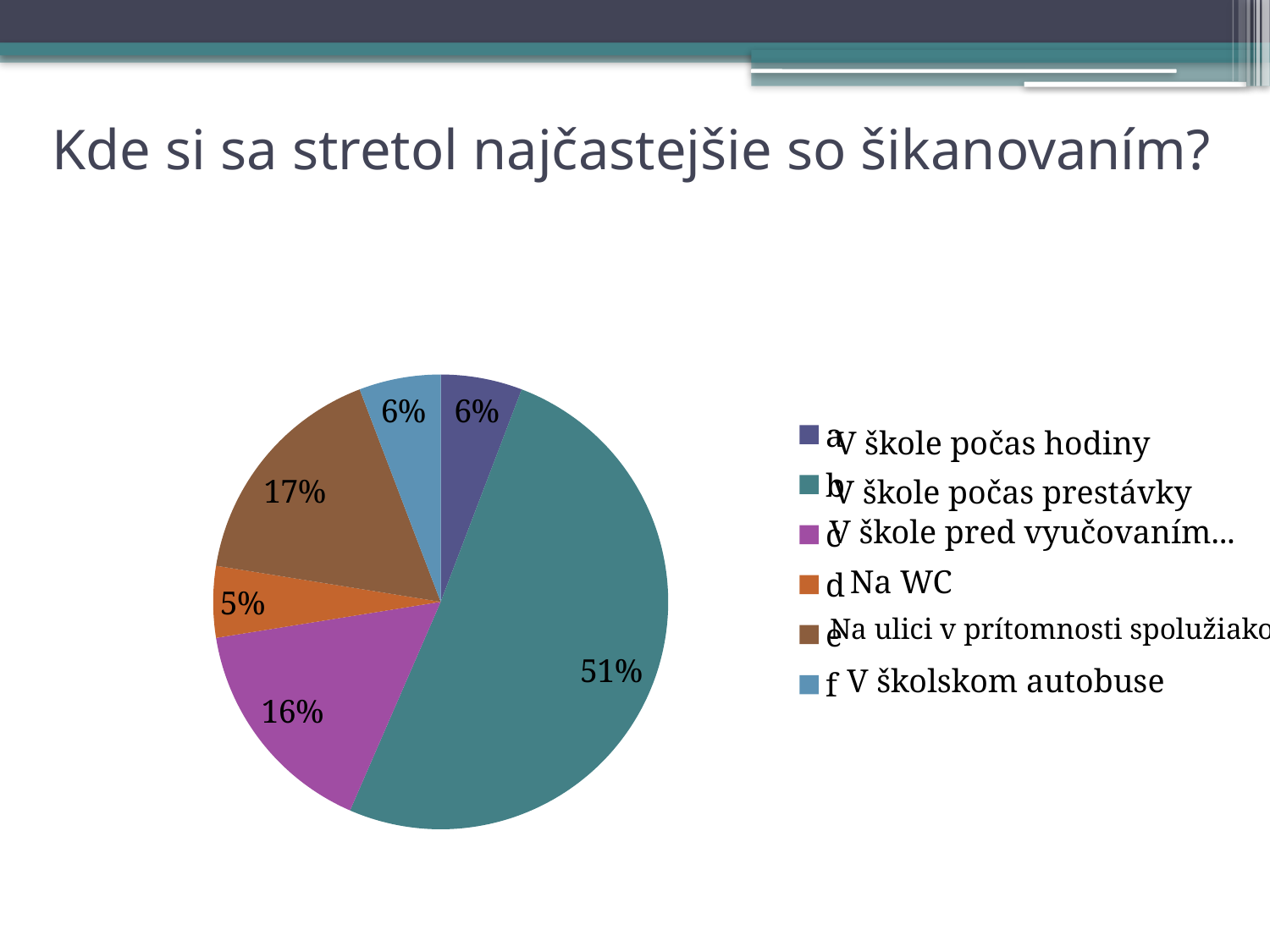
What share of the pie does "Na WC" (d) take? 5% What share of the pie does "V škole počas prestávky" (b) take? 51% Which is larger: the share for "Na ulici v prítomnosti spolužiakov" (e) or the share for "V škole pred vyučovaním..." (c)? Na ulici v prítomnosti spolužiakov What colour is the slice for "Na WC" (d)? orange What is the title of the slide containing the pie chart? Kde si sa stretol najčastejšie so šikanovaním? How many slices does the pie chart have? 6 What kind of chart is shown on the slide? pie chart Which category has the smallest slice of the pie? Na WC What share of the pie does "V školskom autobuse" (f) take? 6% Which category has the largest slice of the pie? V škole počas prestávky What is the difference between the share for "V škole počas prestávky" and the share for "V škole pred vyučovaním..."? 35%